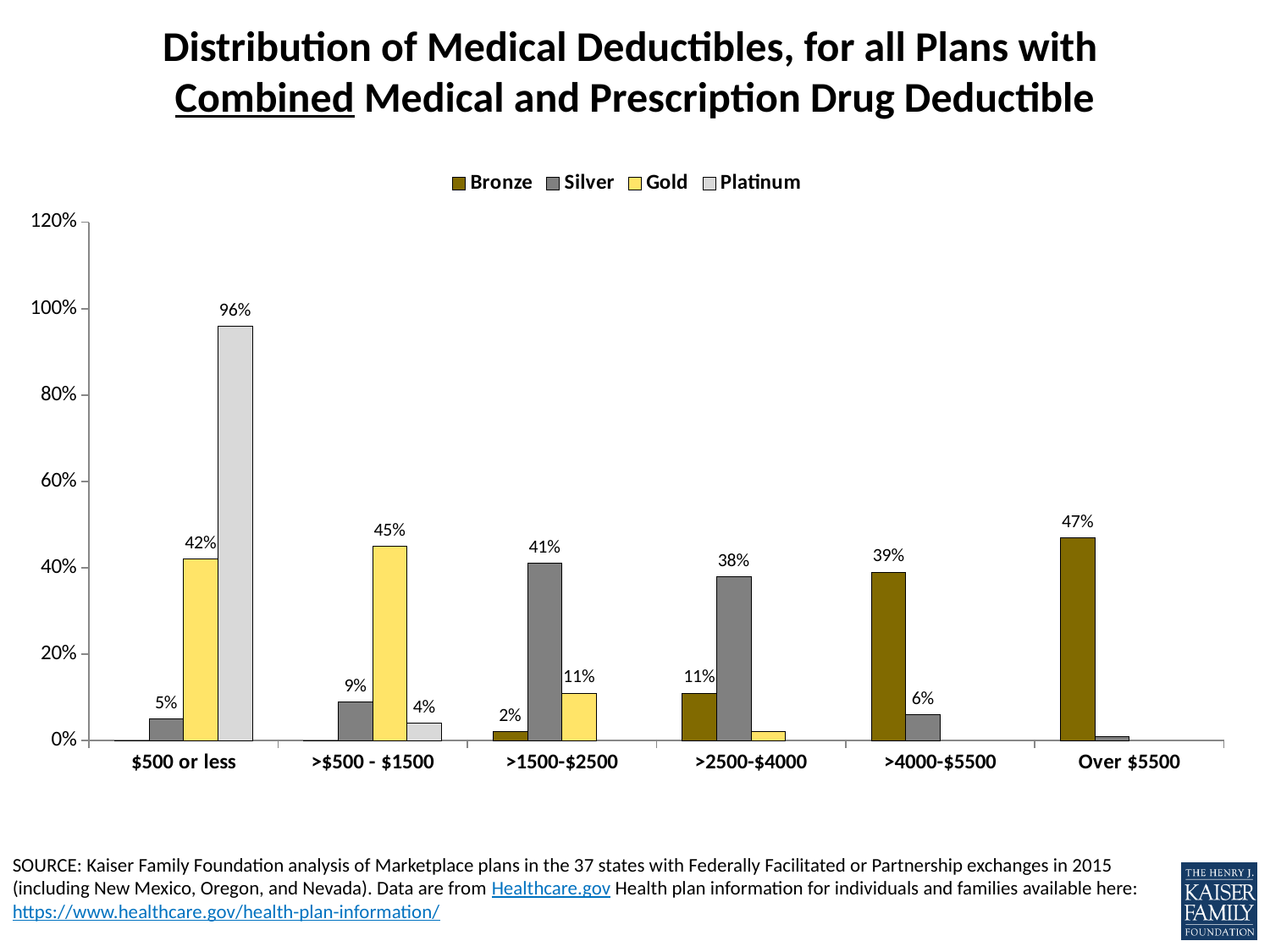
What is the Silver value for the ">1500-$2500" category? 41% What is the Platinum value for the "$500 or less" category? 96% What is the Bronze value for the "Over $5500" category? 47% Is the Bronze value for ">4000-$5500" greater or less than 20%? greater How many deductible categories are shown on the x axis? 6 How many series does the legend list? 4 In which deductible category is the Platinum value highest? $500 or less Which category has the larger Silver value: ">1500-$2500" or ">2500-$4000"? >1500-$2500 What is the difference between the Gold value for ">$500 - $1500" and the Gold value for "$500 or less"? 3 percentage points What is the Gold value for the ">$500 - $1500" category? 45% In which deductible category is the Bronze value highest? Over $5500 What kind of chart is shown on the slide? bar chart